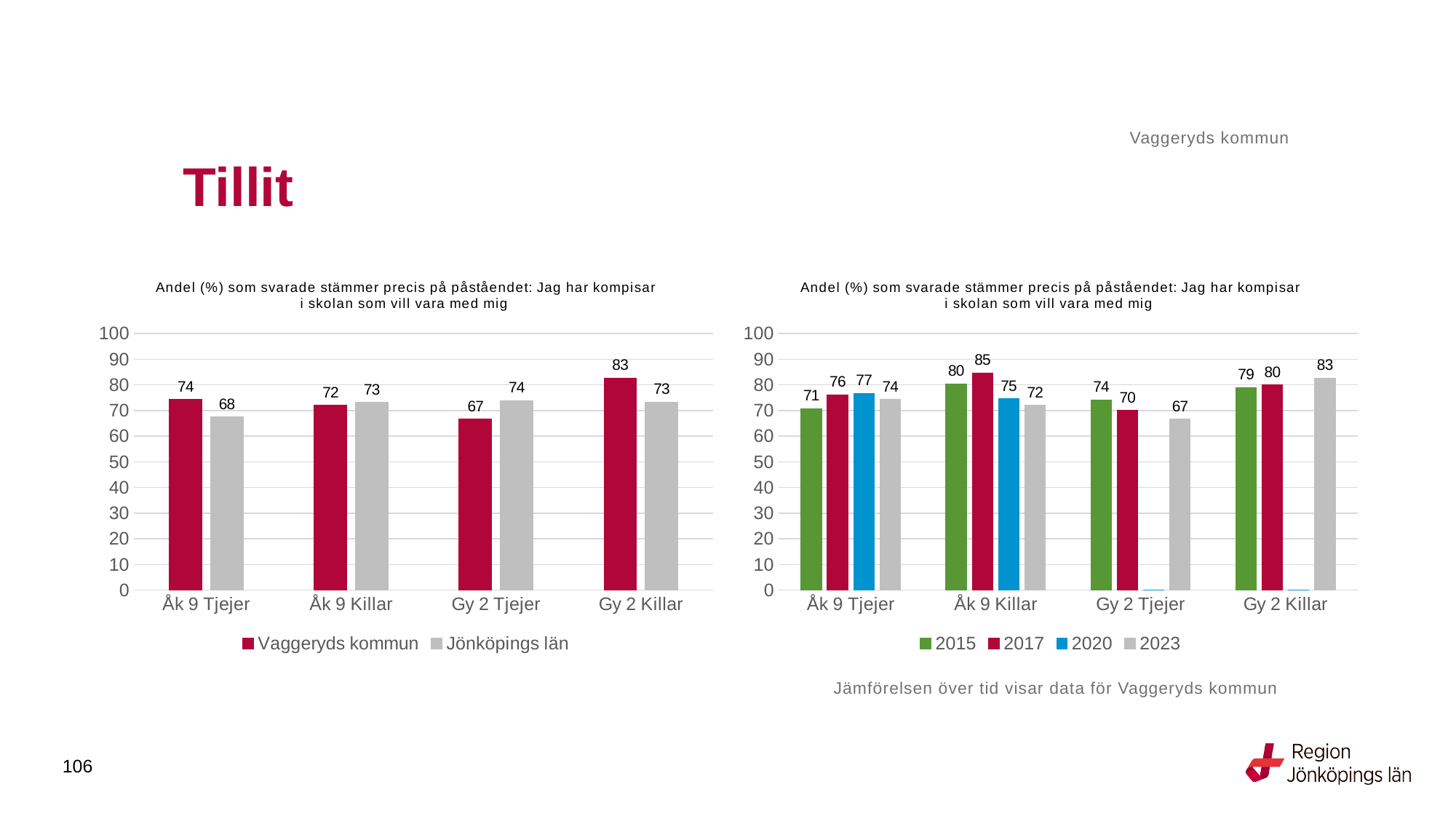
In the left chart, what is the value for Vaggeryds kommun for Gy 2 Killar? 83 In the left chart, what is the difference between Vaggeryds kommun and Jönköpings län for Gy 2 Killar? 10 In the left chart, which category has the highest value for Vaggeryds kommun? Gy 2 Killar In the right chart, what is the value for 2017 for Åk 9 Killar? 85 In the left chart, which is larger for Gy 2 Tjejer: Vaggeryds kommun or Jönköpings län? Jönköpings län What kind of chart is the left chart? Bar chart In the left chart, which category has the lowest value for Vaggeryds kommun? Gy 2 Tjejer In the right chart, what is the difference between the 2015 and 2023 values for Gy 2 Tjejer? 7 In the left chart, what is the value for Jönköpings län for Åk 9 Tjejer? 68 In the right chart, how many series does the legend list? 4 In the right chart, which year has the highest value for Gy 2 Killar? 2023 In the right chart, what is the value for 2020 for Åk 9 Tjejer? 77